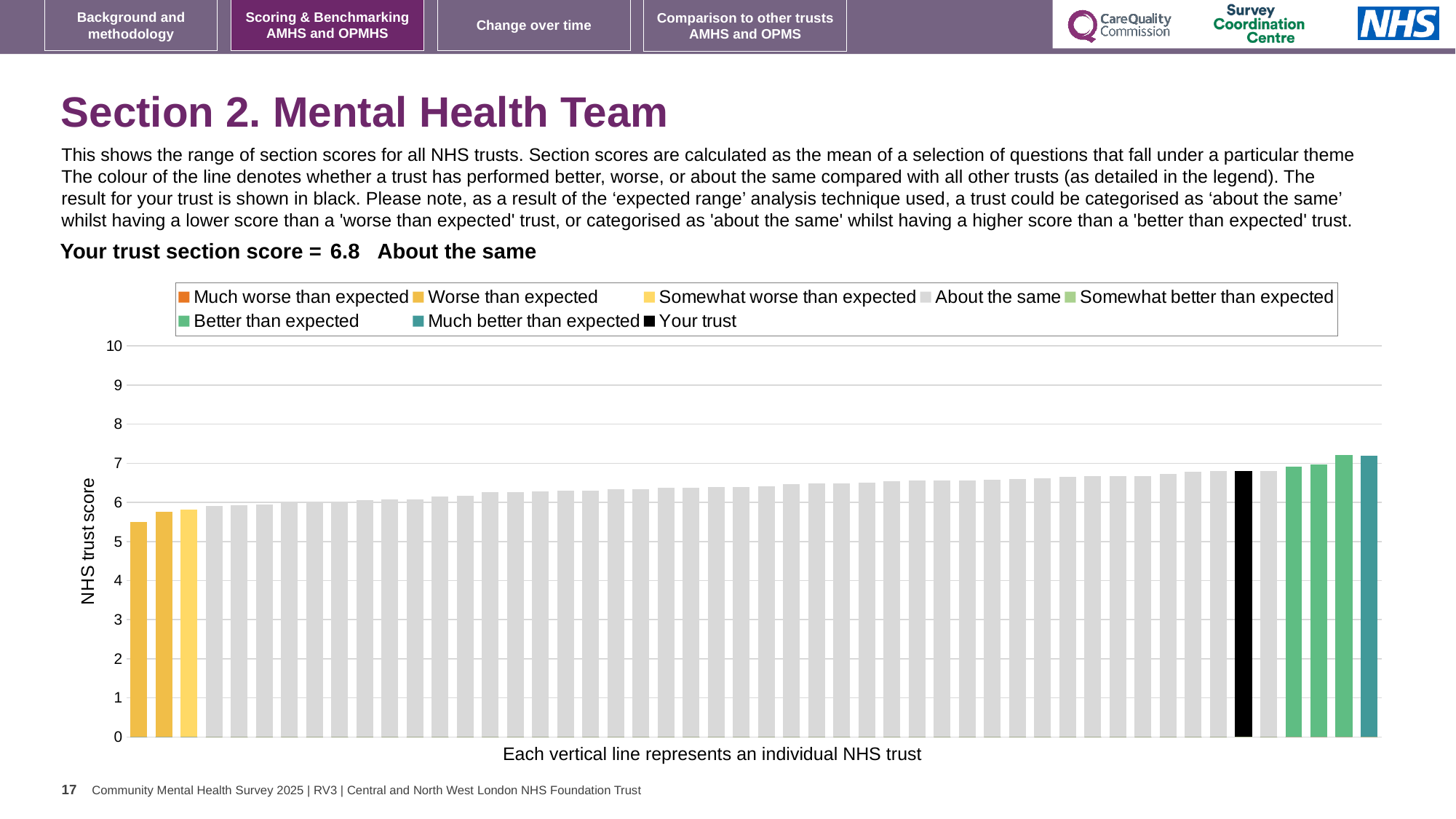
What is the label on the vertical axis of the chart? NHS trust score What is the section score for your trust shown on the slide? 6.8 Is the value for your trust greater or less than 6? greater How many bars are coloured as 'Much better than expected'? 1 Which category is your trust placed in for this section? About the same Is the value of the lowest bar in the chart greater or less than 6? less How many entries does the chart legend list? 8 What kind of chart is shown on the slide? bar chart What is the highest value shown on the vertical axis? 10 What colour is the bar representing your trust? black Is the value for your trust greater or less than 7? less Do the bar values rise or fall from left to right along the x axis? rise